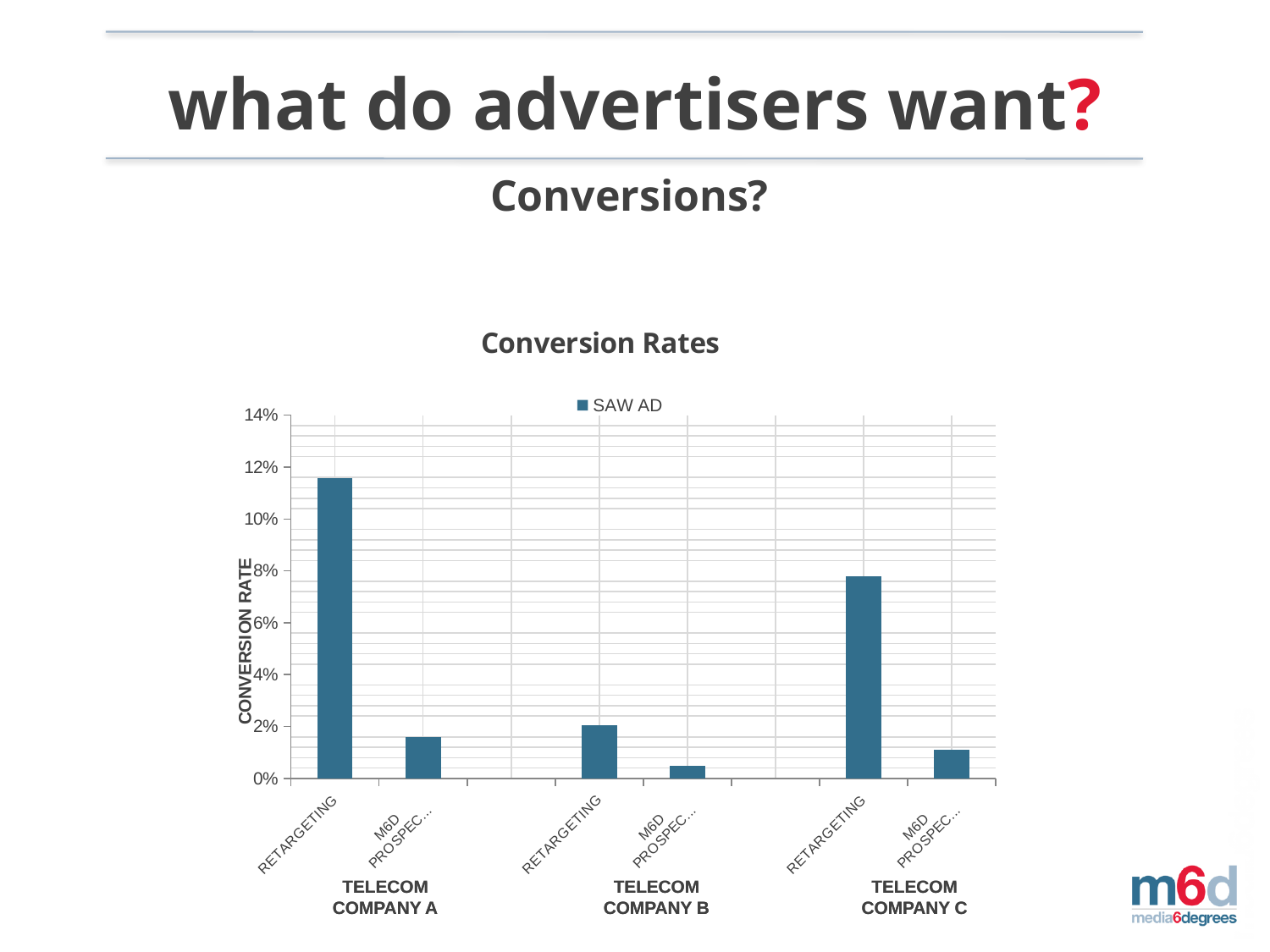
How many telecom companies are shown along the x axis of the Conversion Rates chart? 3 Which bar is the lowest in the Conversion Rates chart? M6D PROSPEC... for TELECOM COMPANY B What kind of chart is shown on the slide? bar chart What is the name of the series shown in the legend of the Conversion Rates chart? SAW AD Which is larger: the RETARGETING value for TELECOM COMPANY A or the RETARGETING value for TELECOM COMPANY C? TELECOM COMPANY A Which bar is the highest in the Conversion Rates chart? RETARGETING for TELECOM COMPANY A Is the RETARGETING value for TELECOM COMPANY A greater or less than 10%? greater How many bars are plotted in the Conversion Rates chart? 6 How many series does the legend of the Conversion Rates chart list? 1 Is the RETARGETING value for TELECOM COMPANY B greater or less than 4%? less What is the label on the vertical axis of the Conversion Rates chart? CONVERSION RATE Is the RETARGETING value for TELECOM COMPANY C greater or less than 6%? greater